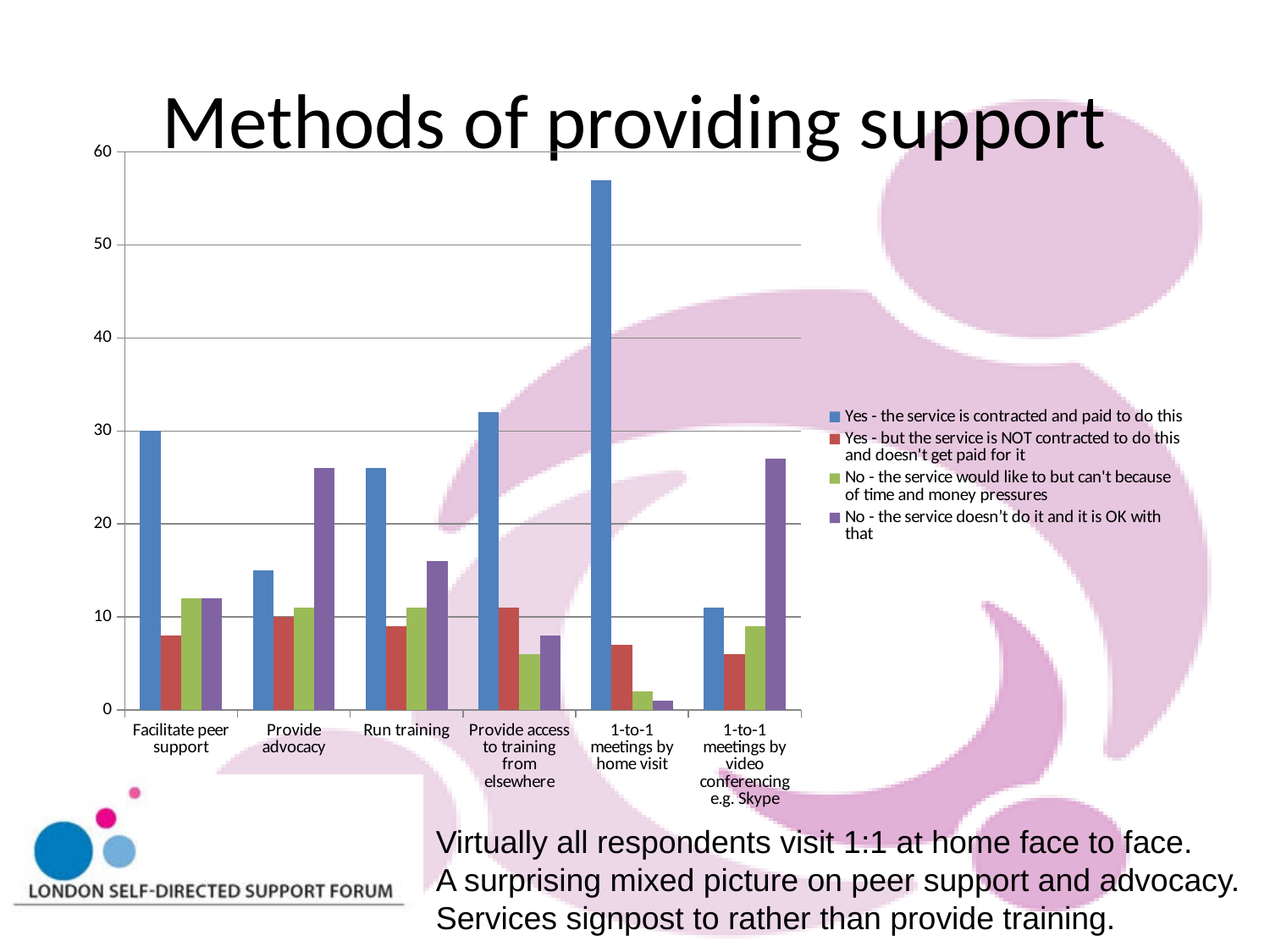
What is the title of the chart? Methods of providing support How many categories are shown along the x axis? 6 Which colour represents the series 'Yes - the service is contracted and paid to do this'? blue How many series does the legend list? 4 Which category has the lowest value for the series 'No - the service doesn't do it and it is OK with that'? 1-to-1 meetings by home visit For 'Provide advocacy', which series has the larger value: 'Yes - the service is contracted and paid to do this' or 'No - the service doesn't do it and it is OK with that'? No - the service doesn't do it and it is OK with that Is the value for 'Provide access to training from elsewhere' in the series 'Yes - the service is contracted and paid to do this' greater or less than 30? greater Is the value for 'Provide advocacy' in the series 'Yes - the service is contracted and paid to do this' greater or less than 20? less Which category has the highest value for the series 'Yes - the service is contracted and paid to do this'? 1-to-1 meetings by home visit What kind of chart is shown on the slide? bar chart Is the value for '1-to-1 meetings by video conferencing e.g. Skype' in the series 'No - the service doesn't do it and it is OK with that' greater or less than 20? greater